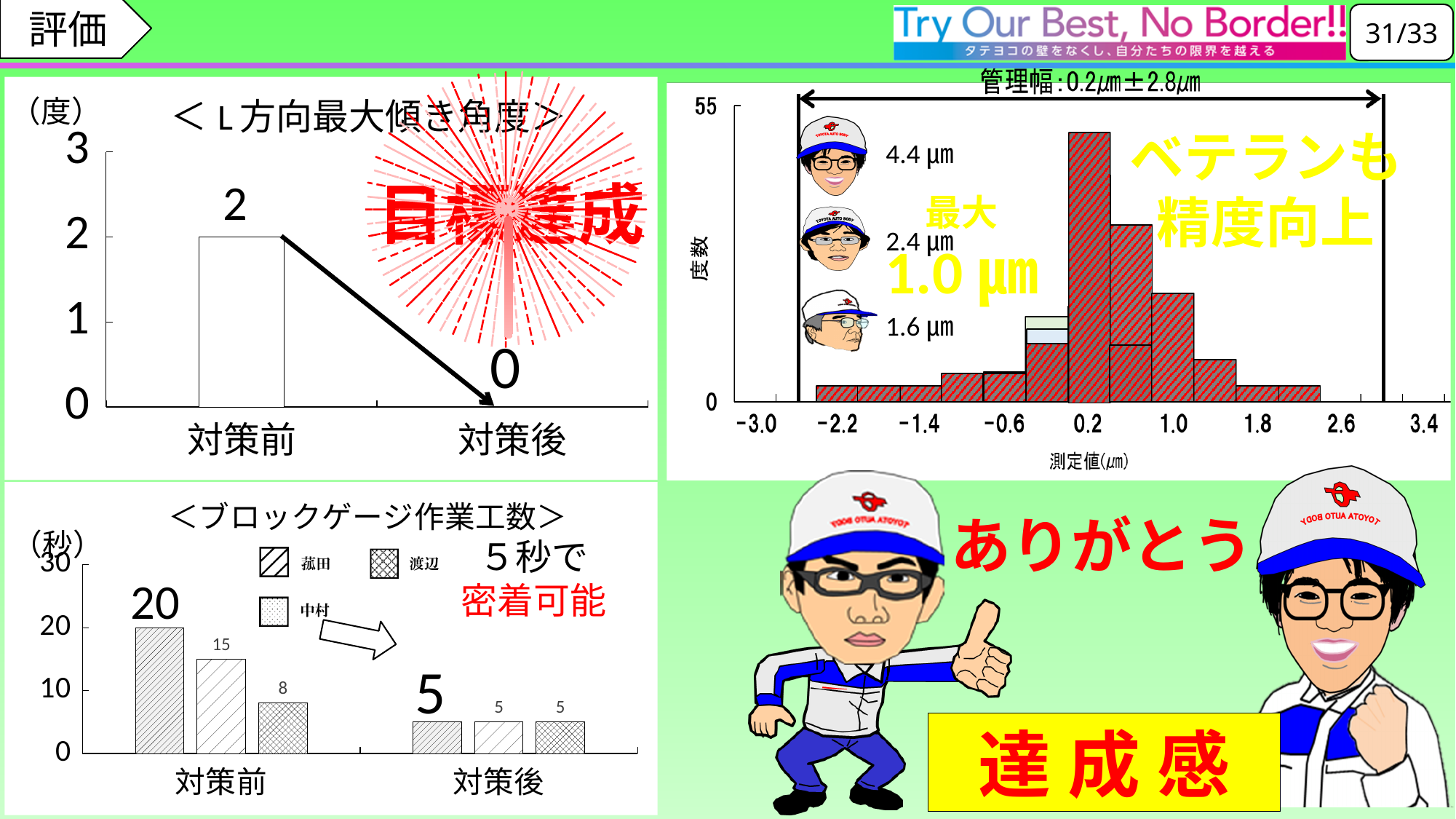
In the ＜ブロックゲージ作業工数＞ chart, what is the value for 渡辺 at 対策前? 8 In the ＜ブロックゲージ作業工数＞ chart, how many series does the legend list? 3 In the ＜ブロックゲージ作業工数＞ chart, what is the value for 中村 at 対策前? 15 In the ＜ブロックゲージ作業工数＞ chart, what is the difference between 菰田 at 対策前 and 菰田 at 対策後? 15 In the ＜ブロックゲージ作業工数＞ chart, what is the value for 菰田 at 対策前? 20 What kind of chart is the top-right chart with the x axis 測定値(μm)? bar chart (histogram) In the ＜ブロックゲージ作業工数＞ chart, which series has the highest value at 対策前? 菰田 In the ＜L方向最大傾き角度＞ chart, what is the difference between 対策前 and 対策後? 2 In the ＜L方向最大傾き角度＞ chart, what is the value for 対策後? 0 In the ＜L方向最大傾き角度＞ chart, what is the value for 対策前? 2 In the ＜L方向最大傾き角度＞ chart, do the values rise or fall from 対策前 to 対策後? fall In the ＜ブロックゲージ作業工数＞ chart, what is the value for 菰田 at 対策後? 5